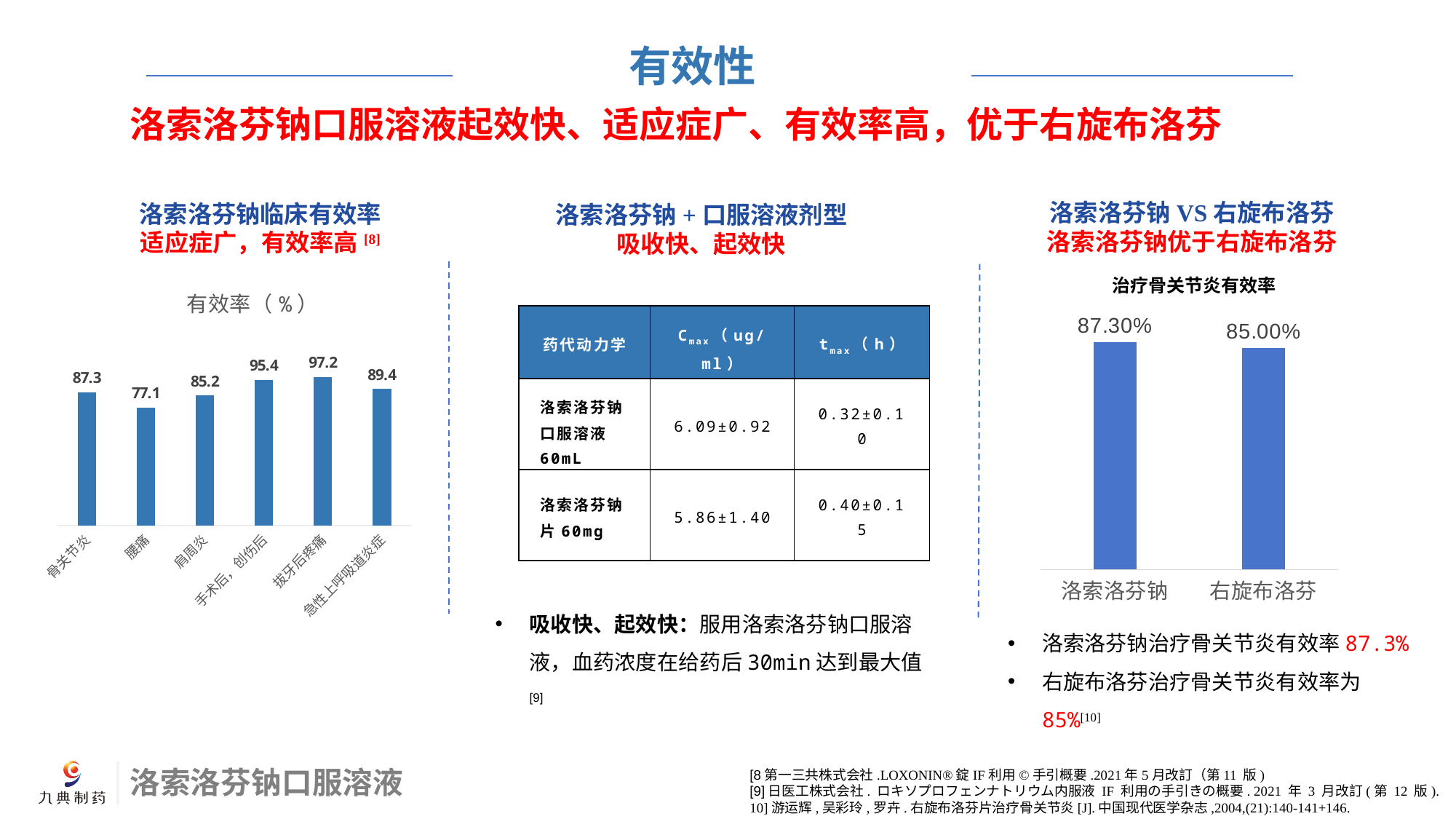
How many bars are shown in the right chart titled 治疗骨关节炎有效率? 2 In the left chart titled 有效率（%）, what is the value for 腰痛? 77.1 What kind of chart is the left chart titled 有效率（%）? bar chart In the left chart titled 有效率（%）, what is the value for 骨关节炎? 87.3 In the right chart titled 治疗骨关节炎有效率, what is the value for 洛索洛芬钠? 87.30% In the right chart titled 治疗骨关节炎有效率, what is the value for 右旋布洛芬? 85.00% In the right chart titled 治疗骨关节炎有效率, what is the difference between the values for 洛索洛芬钠 and 右旋布洛芬? 2.30% In the left chart titled 有效率（%）, which category has the highest value? 拔牙后疼痛 In the left chart titled 有效率（%）, which category has the lowest value? 腰痛 In the left chart titled 有效率（%）, which is larger, the value for 肩周炎 or the value for 急性上呼吸道炎症? 急性上呼吸道炎症 In the left chart titled 有效率（%）, what is the difference between the values for 拔牙后疼痛 and 腰痛? 20.1 How many categories are shown in the left chart titled 有效率（%）? 6